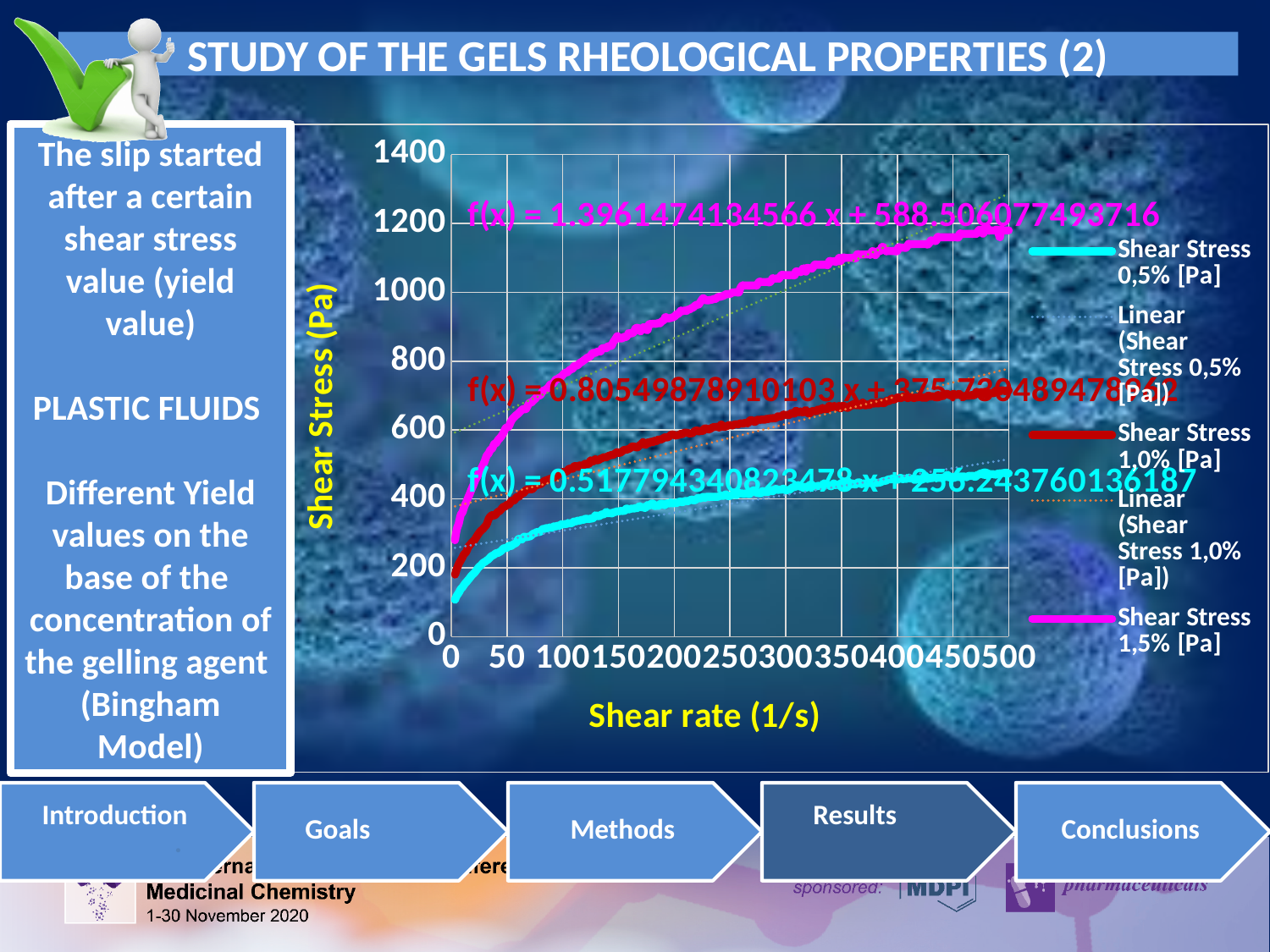
At a shear rate of 500 1/s, which series has the larger shear stress: Shear Stress 1,0% [Pa] or Shear Stress 0,5% [Pa]? Shear Stress 1,0% [Pa] What is the title of the y axis of the chart? Shear Stress (Pa) Is the value of Shear Stress 0,5% [Pa] at a shear rate of 500 1/s greater or less than 600? less What is the title of the x axis of the chart? Shear rate (1/s) What is the slope in the linear trendline equation shown for the Shear Stress 1,5% [Pa] series? 1.3961474134566 Do the shear stress values rise or fall as the shear rate increases? rise What type of chart is shown on the slide? line chart Which series has the highest shear stress values across the shear rate range? Shear Stress 1,5% [Pa] Which series has the lowest shear stress values across the shear rate range? Shear Stress 0,5% [Pa] Is the value of Shear Stress 1,5% [Pa] at a shear rate of 500 1/s greater or less than 1000? greater How many entries does the chart legend list? 5 What is the intercept in the linear trendline equation shown for the Shear Stress 1,5% [Pa] series? 588.506077493716